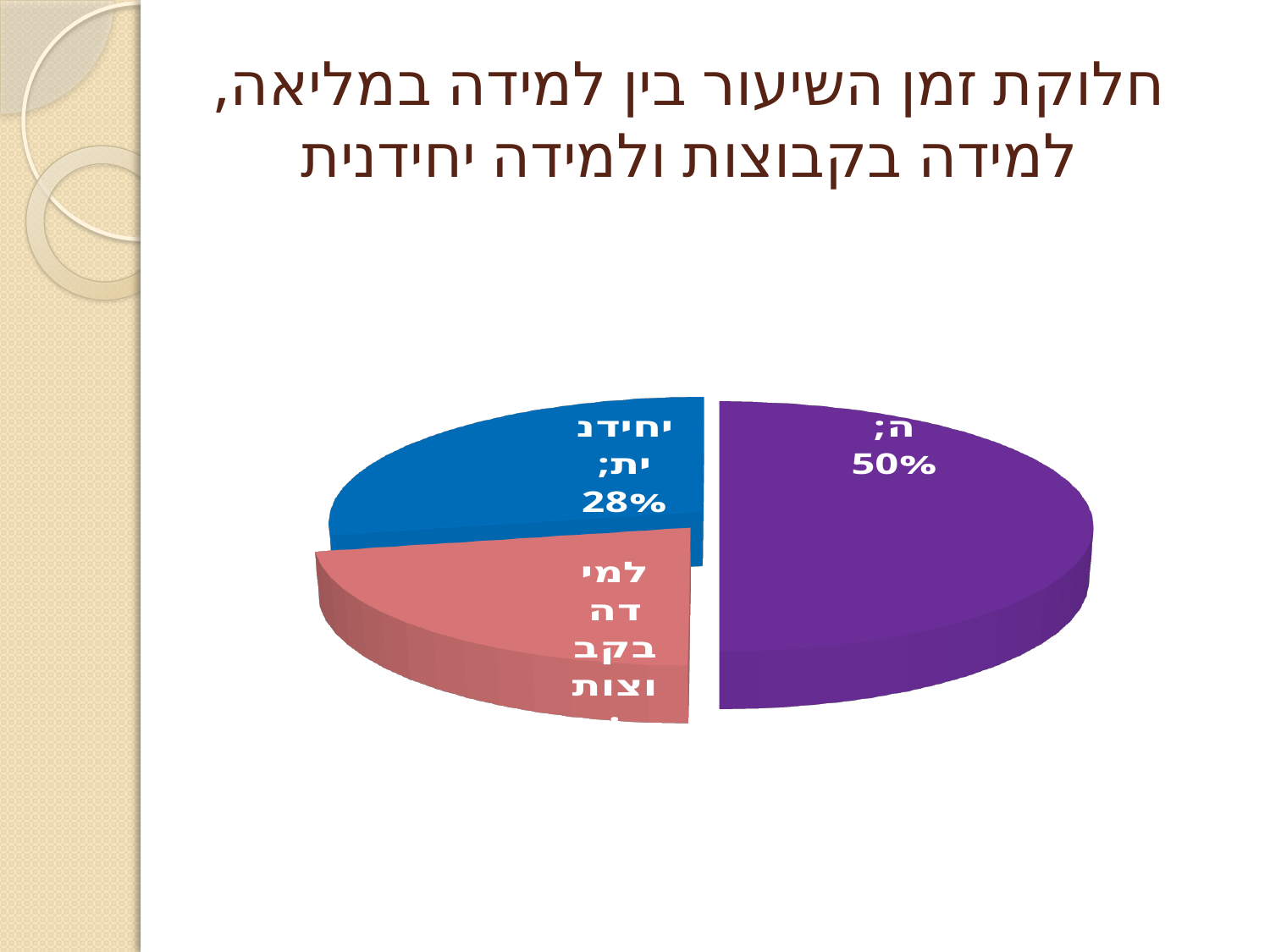
What share of the pie does the יחידנית slice represent? 28% What kind of chart is shown on the slide? Pie chart Which is larger, the purple slice or the blue יחידנית slice? The purple slice What is the title of the slide containing the pie chart? חלוקת זמן השיעור בין למידה במליאה, למידה בקבוצות ולמידה יחידנית What colour is the יחידנית slice? Blue What is the difference in percentage points between the purple slice (50%) and the יחידנית slice (28%)? 22 What percentage is shown on the purple slice of the pie chart? 50% Which slice of the pie chart is the largest? The purple slice (50%) Which is larger, the purple slice or the pink למידה בקבוצות slice? The purple slice What percentage is shown for the יחידנית slice? 28% How many slices does the pie chart have? 3